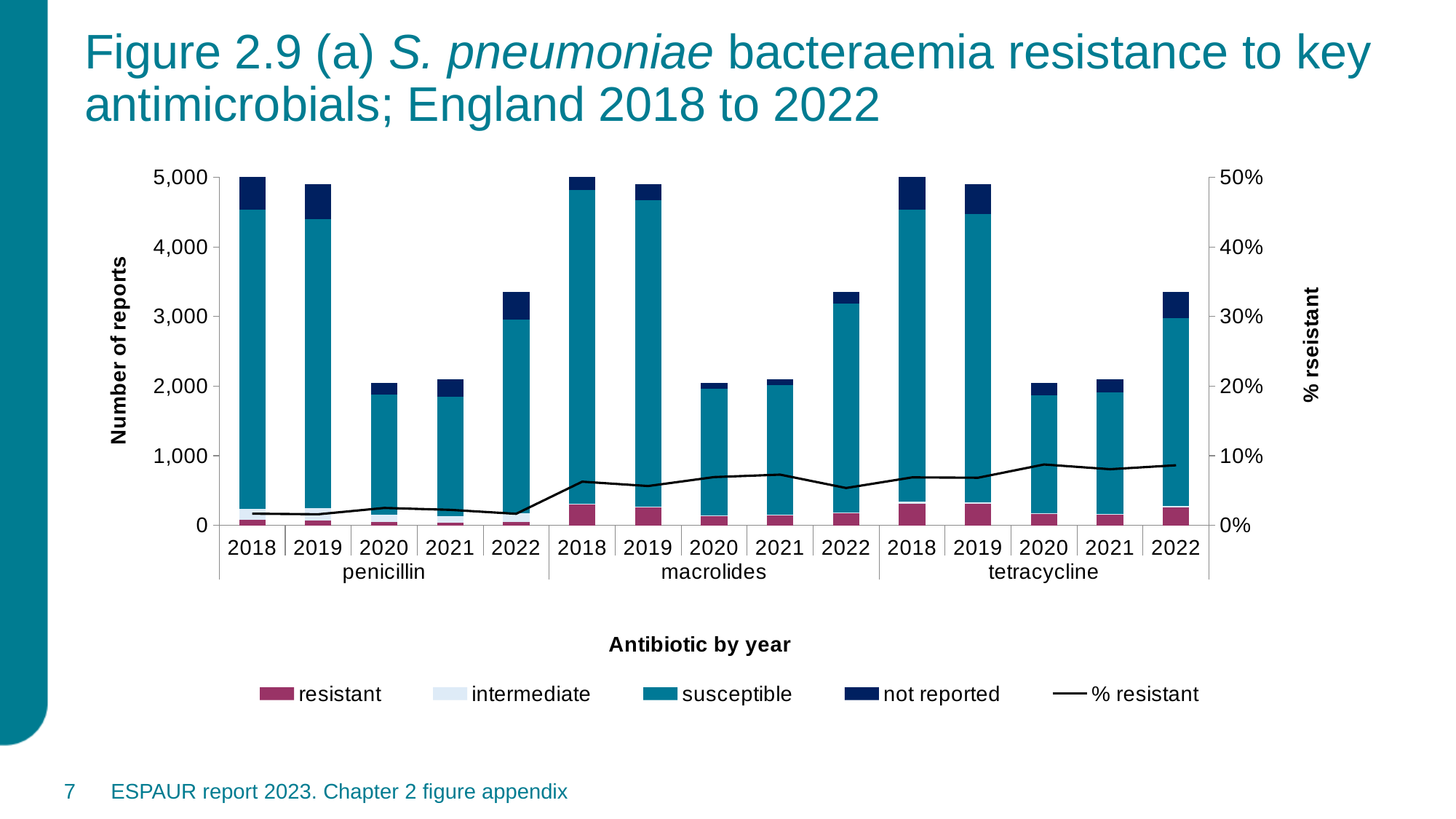
How many bars are plotted in total across all antibiotic groups? 15 Which has a higher % resistant value: penicillin in 2022 or macrolides in 2022? macrolides in 2022 How many series does the legend list? 5 What kind of chart is shown on the slide? Stacked bar chart with a line What is the title of the left vertical axis? Number of reports How many antibiotic groups are shown on the x axis? 3 Is the % resistant value for penicillin in 2018 greater or less than 10%? less Is the total number of reports for macrolides in 2019 greater or less than 4,000? greater Is the total number of reports for penicillin in 2022 greater or less than 3,000? greater Which has more total reports: penicillin in 2018 or penicillin in 2020? penicillin in 2018 Does the % resistant line generally rise or fall moving from the penicillin group to the tetracycline group along the x axis? rise Which antibiotic group has the lowest % resistant line across all years? penicillin